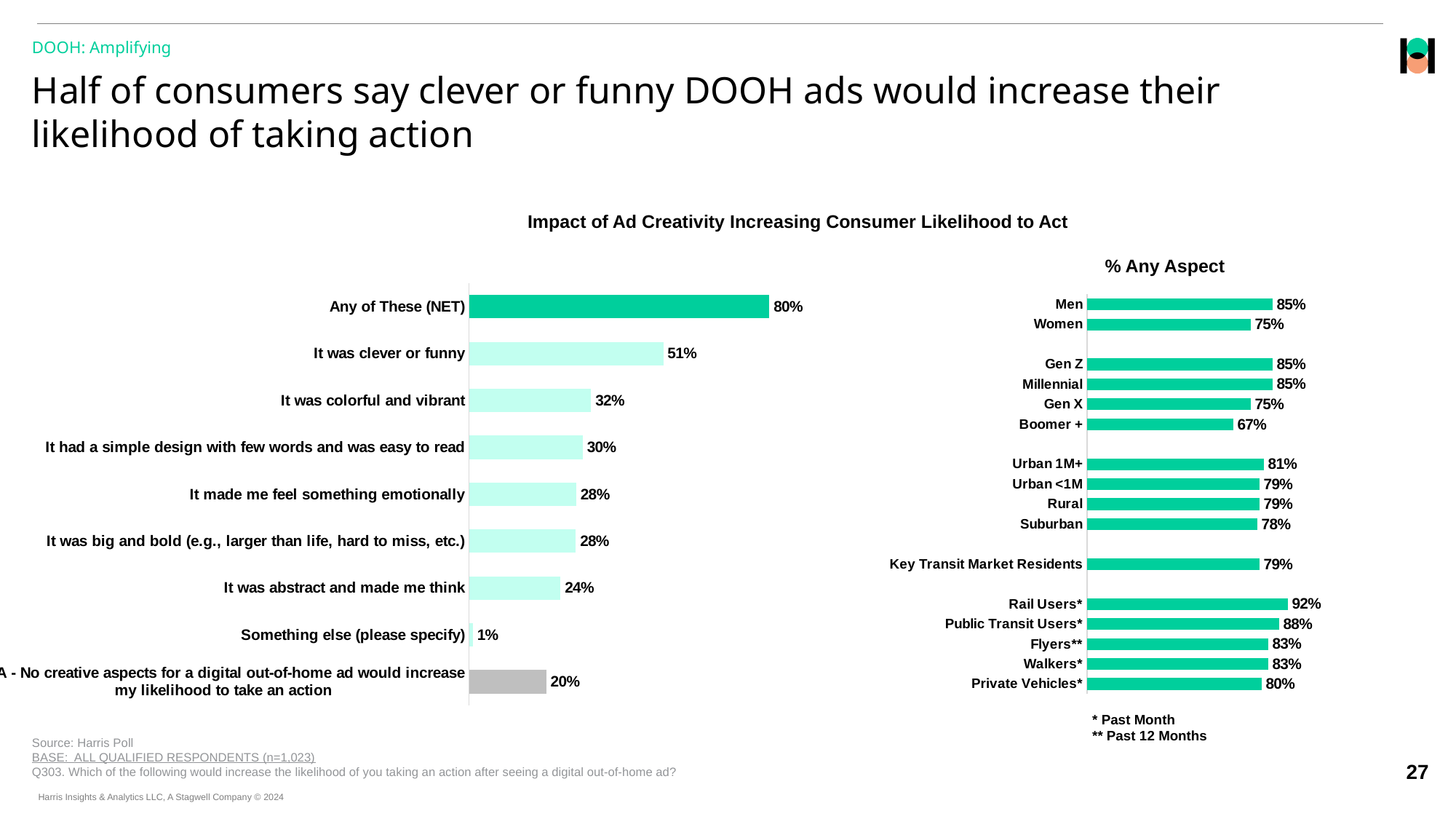
In the left chart, which creative aspect (excluding the NET bar) has the highest value? It was clever or funny In the left chart (Impact of Ad Creativity Increasing Consumer Likelihood to Act), what is the value for "It was clever or funny"? 51% What type of chart is the left chart? Bar chart In the right chart (% Any Aspect), which group has the highest value? Rail Users* In the right chart (% Any Aspect), what is the value for Key Transit Market Residents? 79% In the left chart, what is the difference between "It was clever or funny" and "It was colorful and vibrant"? 19 percentage points In the left chart, which is larger: "It was colorful and vibrant" or "It had a simple design with few words and was easy to read"? It was colorful and vibrant In the right chart (% Any Aspect), which is larger: Urban 1M+ or Suburban? Urban 1M+ In the left chart, which category has the lowest value? Something else (please specify) In the right chart (% Any Aspect), what is the difference between Men and Women? 10 percentage points In the right chart (% Any Aspect), what is the value for Boomer +? 67% In the left chart, what is the value for "It was abstract and made me think"? 24%